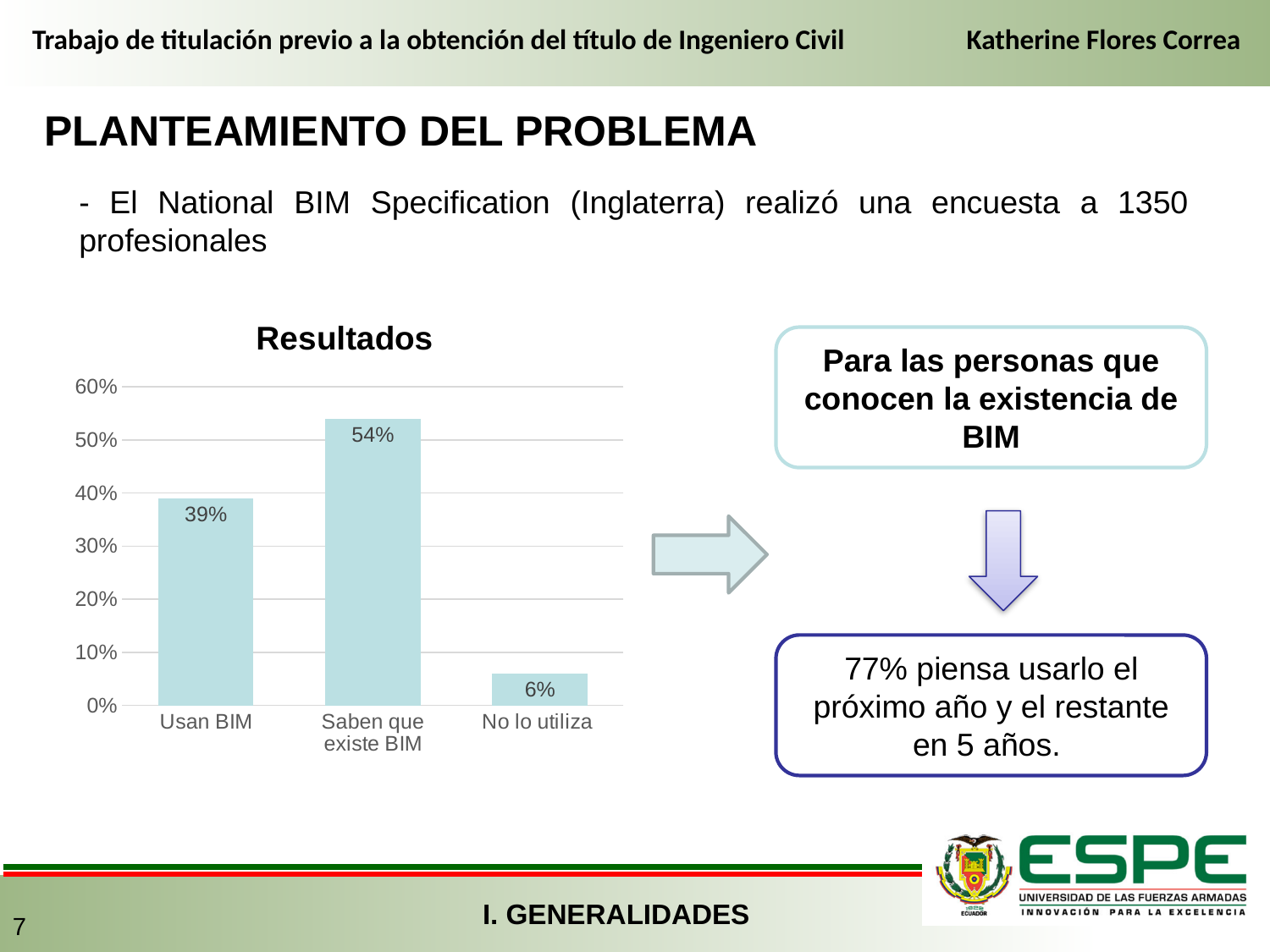
What kind of chart is shown on the slide? Bar chart What is the difference between the values for "Usan BIM" and "No lo utiliza"? 33% What is the value for "No lo utiliza"? 6% Which is larger, the value for "Usan BIM" or the value for "No lo utiliza"? Usan BIM Is the value for "Saben que existe BIM" greater or less than 50%? greater Which category has the highest value? Saben que existe BIM How many categories are shown in the chart? 3 Which category has the lowest value? No lo utiliza What is the difference between the values for "Saben que existe BIM" and "Usan BIM"? 15% What is the title of the chart? Resultados What is the value for "Usan BIM"? 39% What is the value for "Saben que existe BIM"? 54%